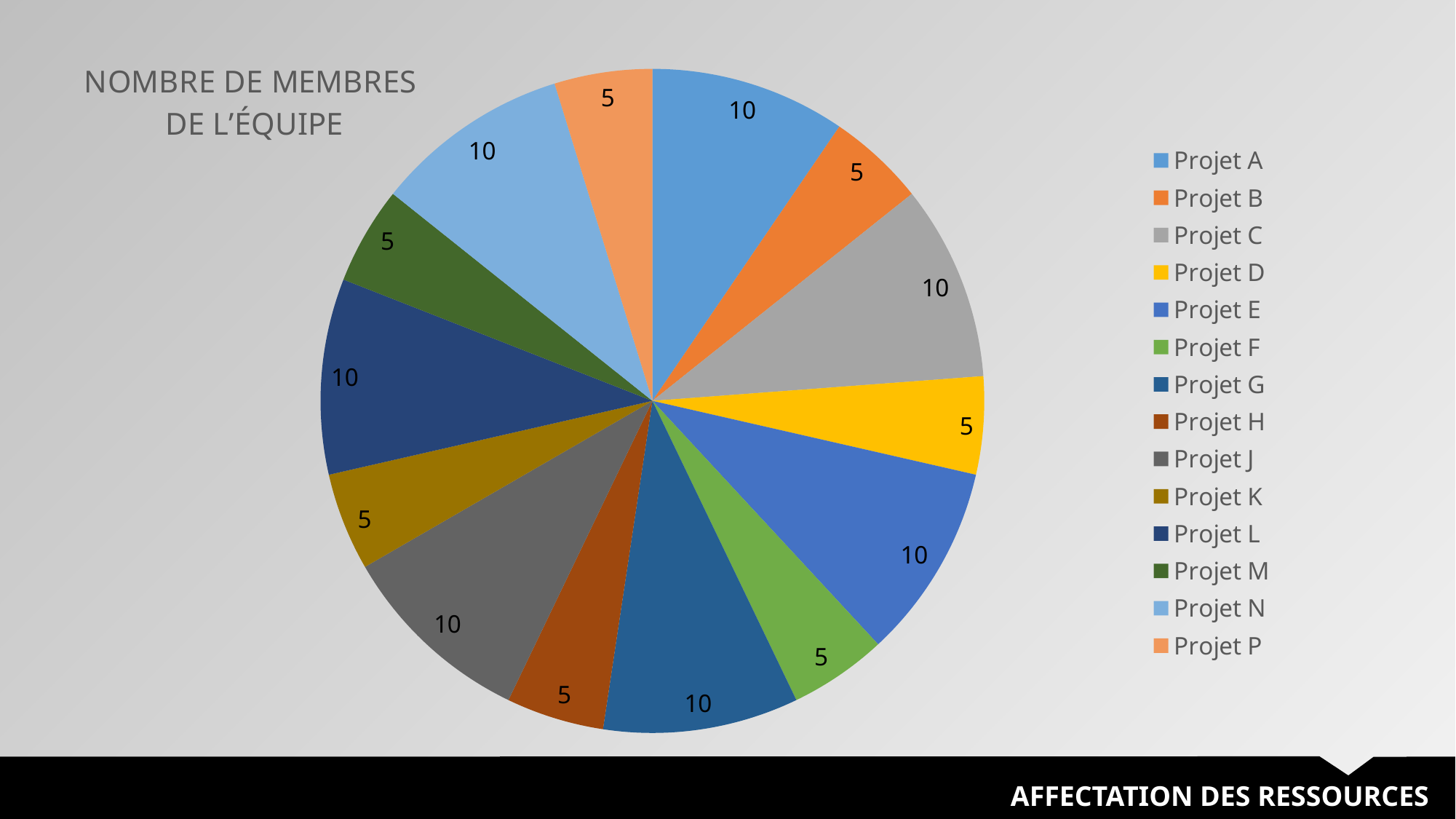
How many slices does the pie chart have? 14 What is the value for Projet A? 10 What is the value for Projet P? 5 What kind of chart is shown on the slide? pie chart Which is larger, the value for Projet C or the value for Projet D? Projet C What is the title of the chart? NOMBRE DE MEMBRES DE L'ÉQUIPE What is the difference between the value for Projet E and the value for Projet F? 5 Which legend entry is listed last? Projet P What is the value for Projet G? 10 What is the total of all the values shown on the pie chart? 105 What is the value for Projet D? 5 What is the value for Projet B? 5